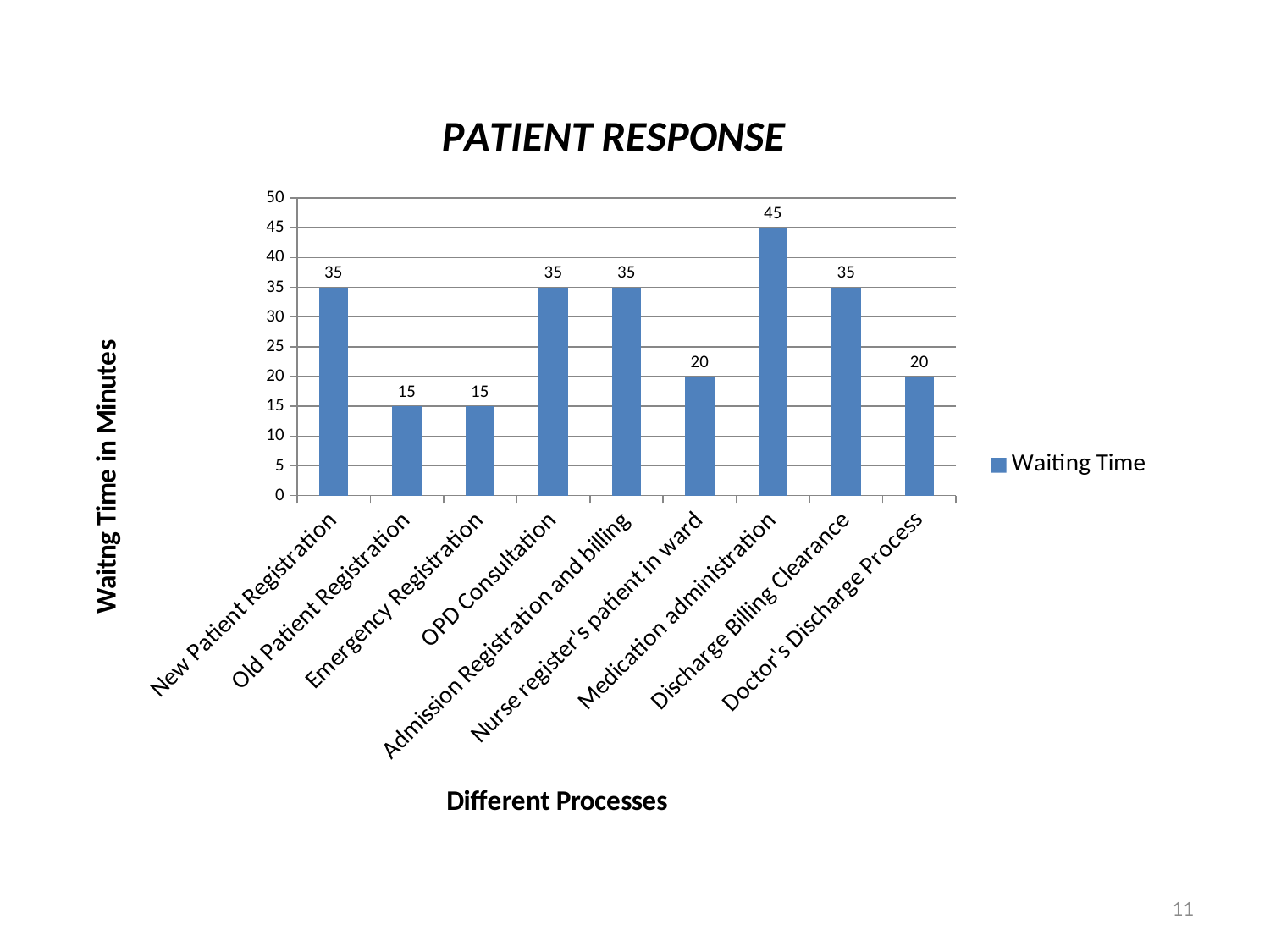
What is the label of the y axis? Waitng Time in Minutes Which has a larger waiting time, OPD Consultation or Doctor's Discharge Process? OPD Consultation How many processes are shown on the x axis? 9 What is the waiting time for Nurse register's patient in ward? 20 Which process has the highest waiting time? Medication administration What kind of chart is shown on the slide? bar chart What is the title of the chart? PATIENT RESPONSE What is the difference in waiting time between Medication administration and Emergency Registration? 30 What is the waiting time for Medication administration? 45 How many series does the legend list? 1 What is the waiting time for Old Patient Registration? 15 Is the waiting time for Discharge Billing Clearance greater or less than 30? greater